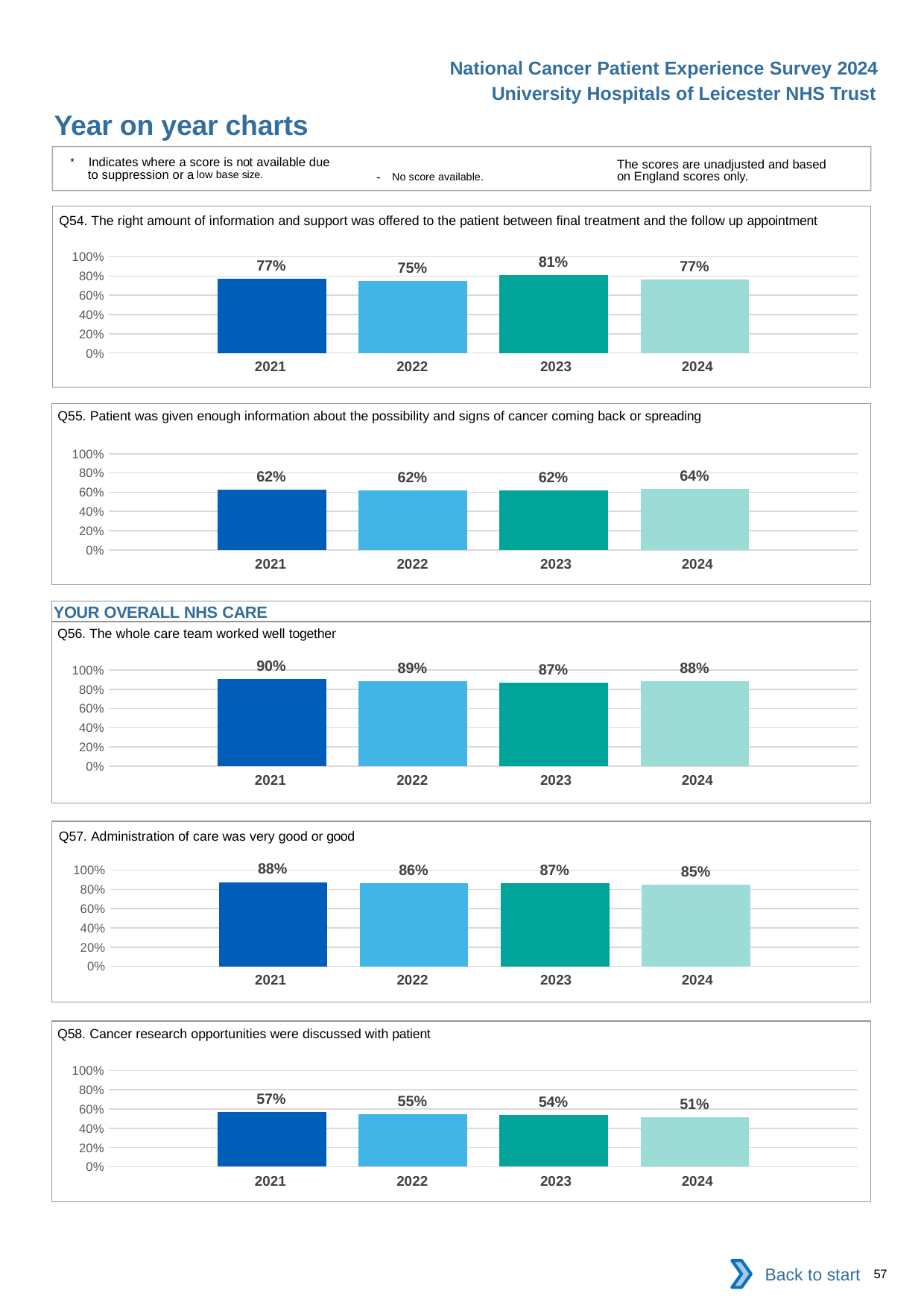
In the Q58 chart, do the values rise or fall from 2021 to 2024? fall In the Q54 chart, what is the value for 2023? 81% In the Q57 chart, which is larger, the value for 2022 or the value for 2024? 2022 In the Q56 chart, which year has the lowest value? 2023 What kind of chart is the Q56 chart? bar chart In the Q57 chart, what is the difference between the 2021 value and the 2024 value? 3% In the Q55 chart, what is the value for 2024? 64% In the Q54 chart, which year has the highest value? 2023 In the Q56 chart, what is the value for 2021? 90% In the Q55 chart, what is the difference between the 2024 value and the 2023 value? 2% In the Q58 chart, what is the value for 2024? 51% How many years are shown on the x axis of the Q58 chart? 4